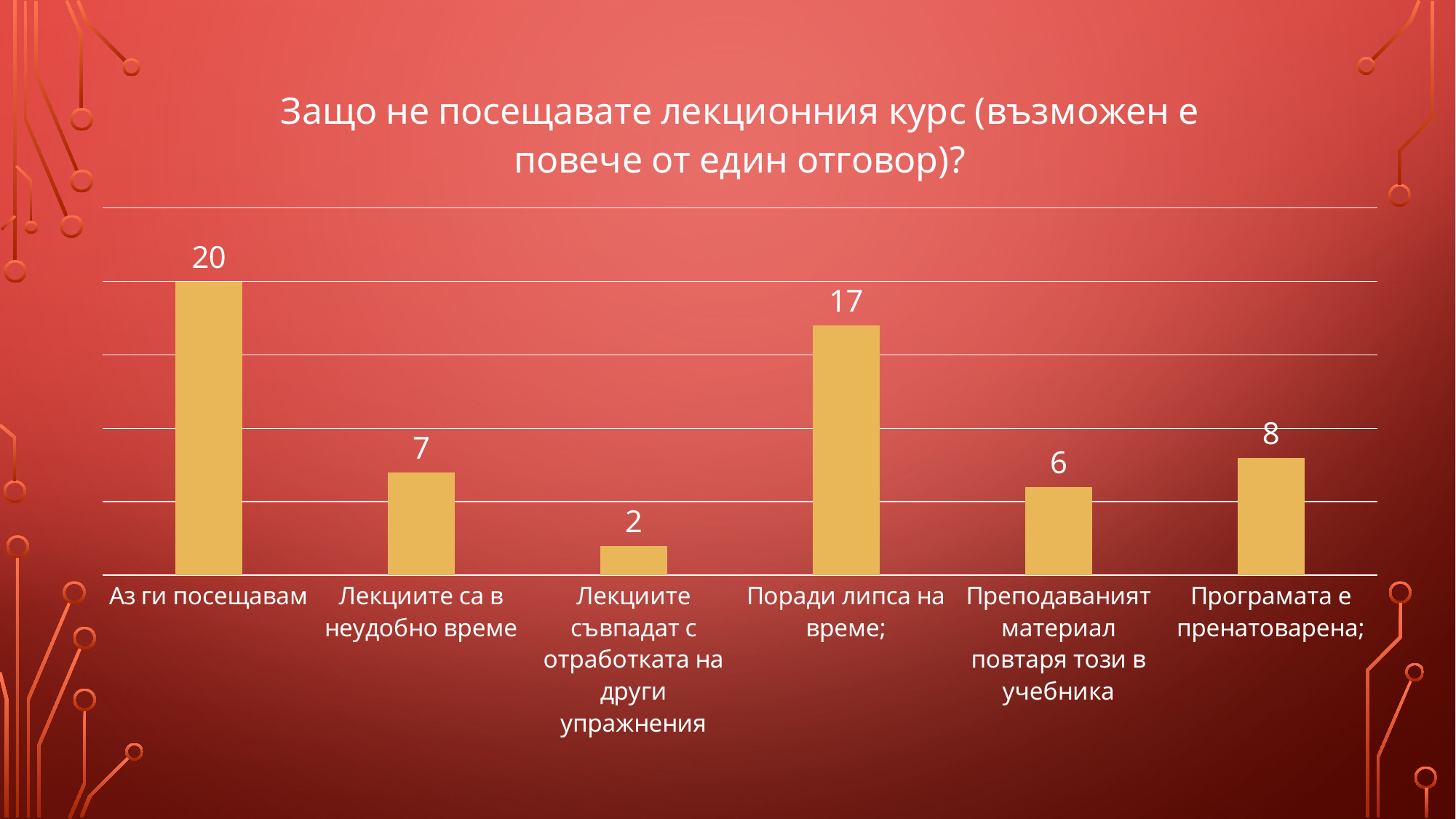
What kind of chart is shown on the slide? Bar chart Which is larger, the value for "Лекциите са в неудобно време" or the value for "Програмата е пренатоварена;"? Програмата е пренатоварена; What is the value for "Аз ги посещавам"? 20 What is the value for "Програмата е пренатоварена;"? 8 What is the difference between the values for "Лекциите са в неудобно време" and "Лекциите съвпадат с отработката на други упражнения"? 5 What is the value for "Преподаваният материал повтаря този в учебника"? 6 Which category has the lowest value? Лекциите съвпадат с отработката на други упражнения What is the value for "Поради липса на време;"? 17 Which category has the highest value? Аз ги посещавам What is the title of the chart? Защо не посещавате лекционния курс (възможен е повече от един отговор)? How many categories are shown in the chart? 6 What is the difference between the values for "Аз ги посещавам" and "Поради липса на време;"? 3